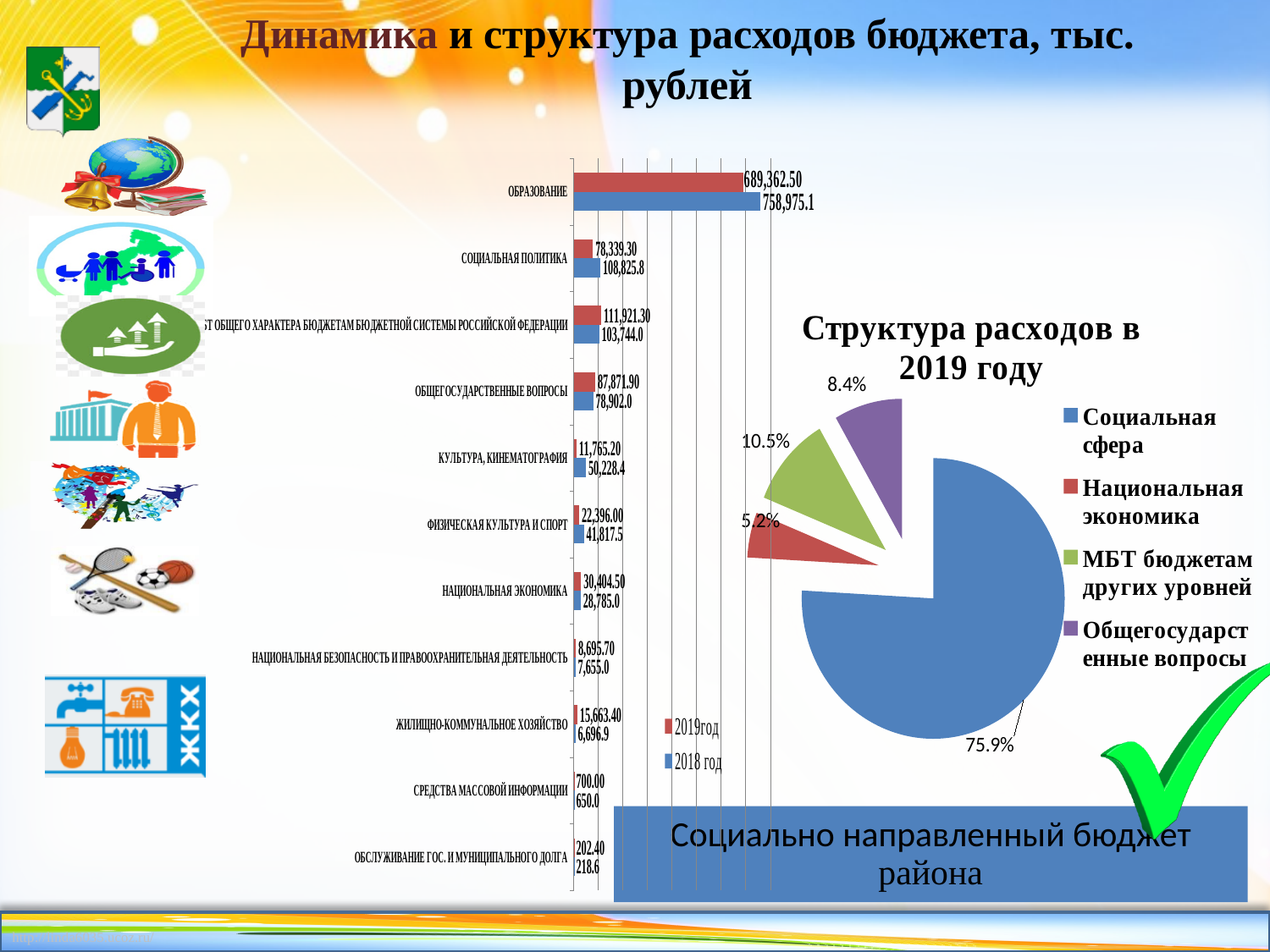
What type of chart is the chart on the left of the slide? bar chart On the bar chart, what is the difference between the 2019 год and 2018 год values for СРЕДСТВА МАССОВОЙ ИНФОРМАЦИИ? 50.00 How many categories does the bar chart show? 11 On the pie chart 'Структура расходов в 2019 году', what share does Социальная сфера have? 75.9% On the bar chart, which is larger for КУЛЬТУРА, КИНЕМАТОГРАФИЯ: the 2019 год value or the 2018 год value? 2018 год On the bar chart, which category has the highest value in 2019 год? ОБРАЗОВАНИЕ On the pie chart 'Структура расходов в 2019 году', which slice is the smallest? Национальная экономика On the bar chart, what is the value for ОБРАЗОВАНИЕ in 2018 год? 758,975.1 On the bar chart, what is the value for СОЦИАЛЬНАЯ ПОЛИТИКА in 2019 год? 78,339.30 On the bar chart, what is the value for ЖИЛИЩНО-КОММУНАЛЬНОЕ ХОЗЯЙСТВО in 2018 год? 6,696.9 How many series does the bar chart legend list? 2 On the bar chart, which category has the lowest value in 2018 год? ОБСЛУЖИВАНИЕ ГОС. И МУНИЦИПАЛЬНОГО ДОЛГА